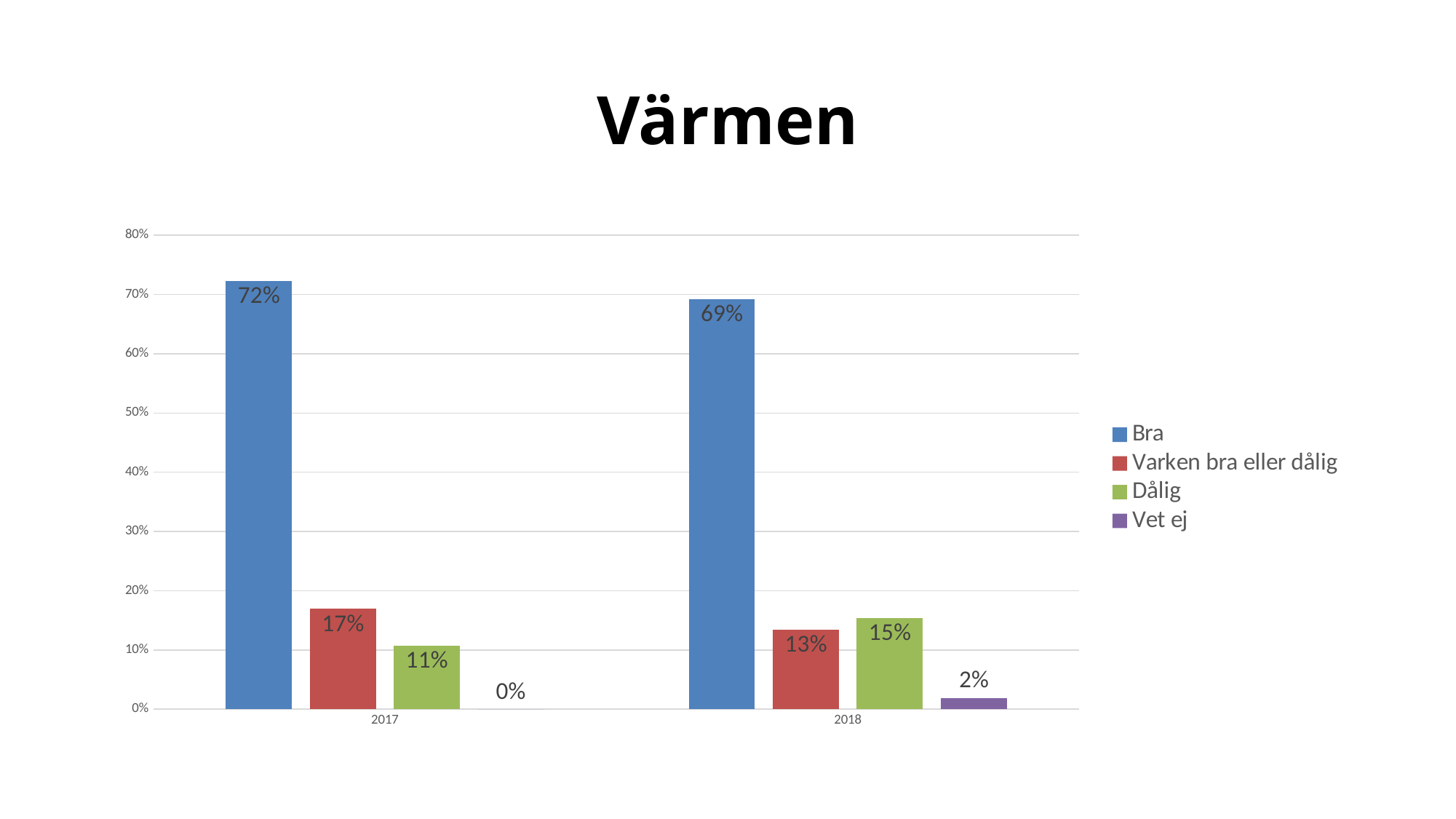
What is the value for Vet ej in 2017? 0% Which series has the lowest value in 2017? Vet ej Which is larger in 2017: Varken bra eller dålig or Dålig? Varken bra eller dålig Is the value for Bra in 2018 greater or less than 60%? greater What is the title of the slide? Värmen What is the value for Bra in 2017? 72% What is the value for Dålig in 2018? 15% What kind of chart is shown on the slide? bar chart What is the difference between the Bra values for 2017 and 2018? 3% What is the value for Varken bra eller dålig in 2018? 13% How many series does the legend list? 4 Which series has the highest value in 2018? Bra